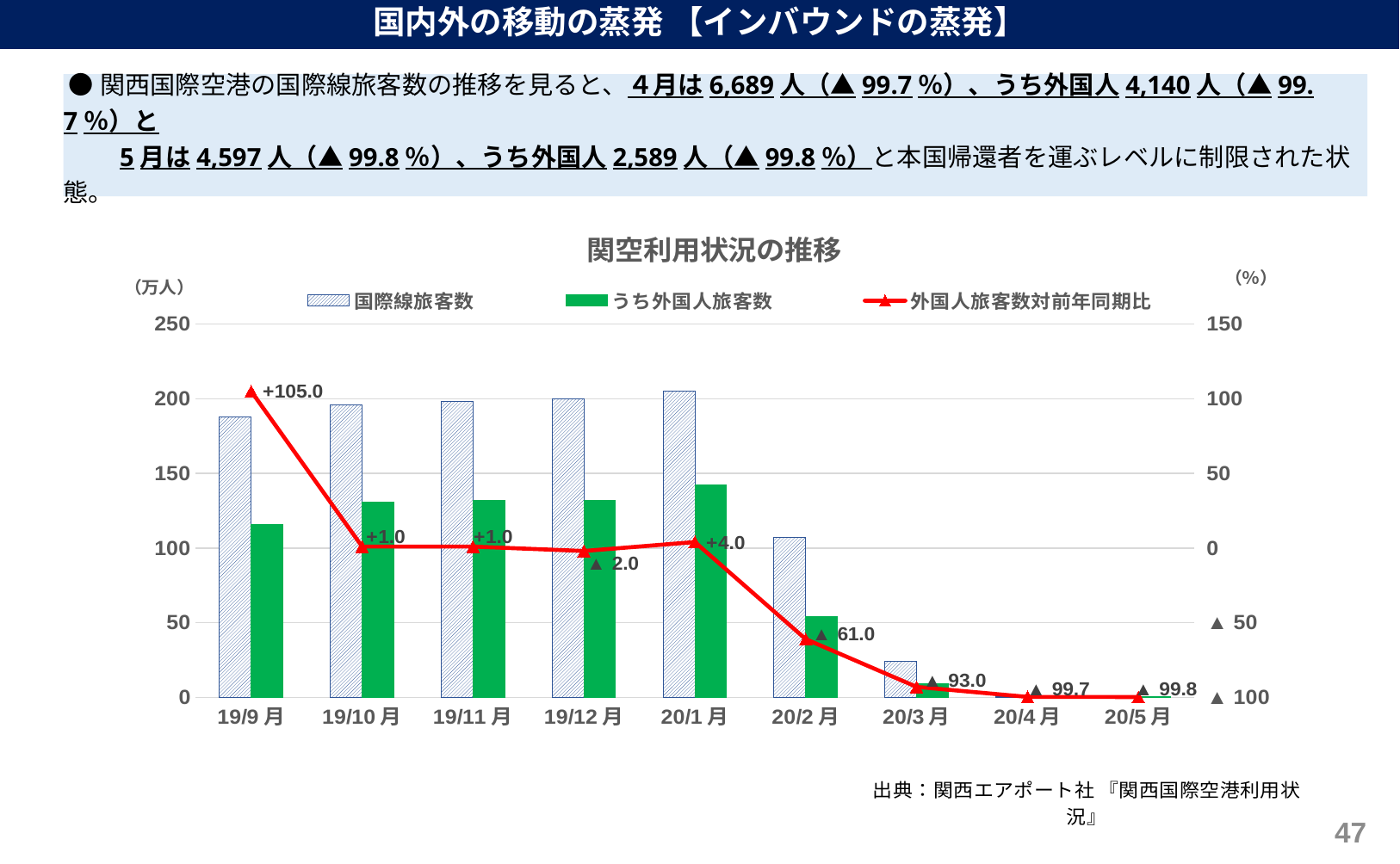
What is the 外国人旅客数対前年同期比 value for 19/9月? +105.0 In which month is 外国人旅客数対前年同期比 lowest? 20/5月 What is the 外国人旅客数対前年同期比 value for 20/2月? ▲ 61.0 What kind of chart is 関空利用状況の推移? combination bar and line chart In which month is 外国人旅客数対前年同期比 highest? 19/9月 What is the 外国人旅客数対前年同期比 value for 20/5月? ▲ 99.8 Is the 国際線旅客数 value for 19/9月 greater or less than 150? greater Does the 外国人旅客数対前年同期比 line rise or fall overall from 19/9月 to 20/5月? fall How many series does the legend of 関空利用状況の推移 list? 3 In 20/1月, which is larger: 国際線旅客数 or うち外国人旅客数? 国際線旅客数 How many months are shown on the x axis of 関空利用状況の推移? 9 Is the うち外国人旅客数 value for 20/3月 greater or less than 50? less